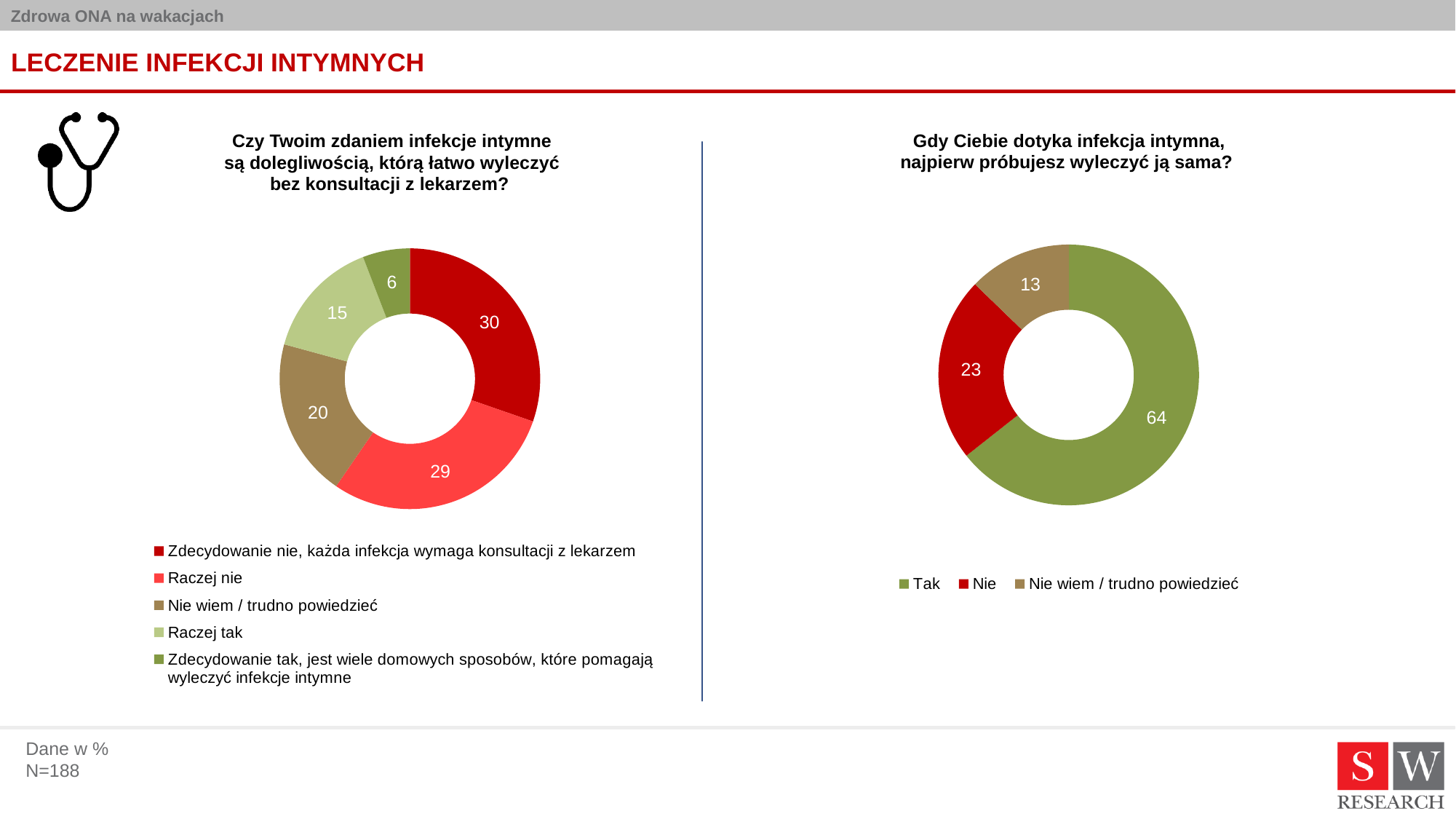
In the right chart ("Gdy Ciebie dotyka infekcja intymna, najpierw próbujesz wyleczyć ją sama?"), what is the value for "Tak"? 64 What type of chart is the right chart? Donut (pie) chart In the left chart, which category has the lowest value? Zdecydowanie tak, jest wiele domowych sposobów, które pomagają wyleczyć infekcje intymne In the left chart, what is the difference between the values for "Nie wiem / trudno powiedzieć" and "Raczej tak"? 5 In the left chart, which category has the highest value? Zdecydowanie nie, każda infekcja wymaga konsultacji z lekarzem In the right chart, which colour represents "Tak"? Green In the left chart ("Czy Twoim zdaniem infekcje intymne są dolegliwością, którą łatwo wyleczyć bez konsultacji z lekarzem?"), what is the value for "Raczej nie"? 29 In the left chart, what is the value for "Zdecydowanie tak, jest wiele domowych sposobów, które pomagają wyleczyć infekcje intymne"? 6 How many categories does the legend of the left chart list? 5 In the right chart, which category has the lowest value? Nie wiem / trudno powiedzieć In the right chart, what is the value for "Nie wiem / trudno powiedzieć"? 13 In the right chart, what is the difference between the values for "Tak" and "Nie"? 41